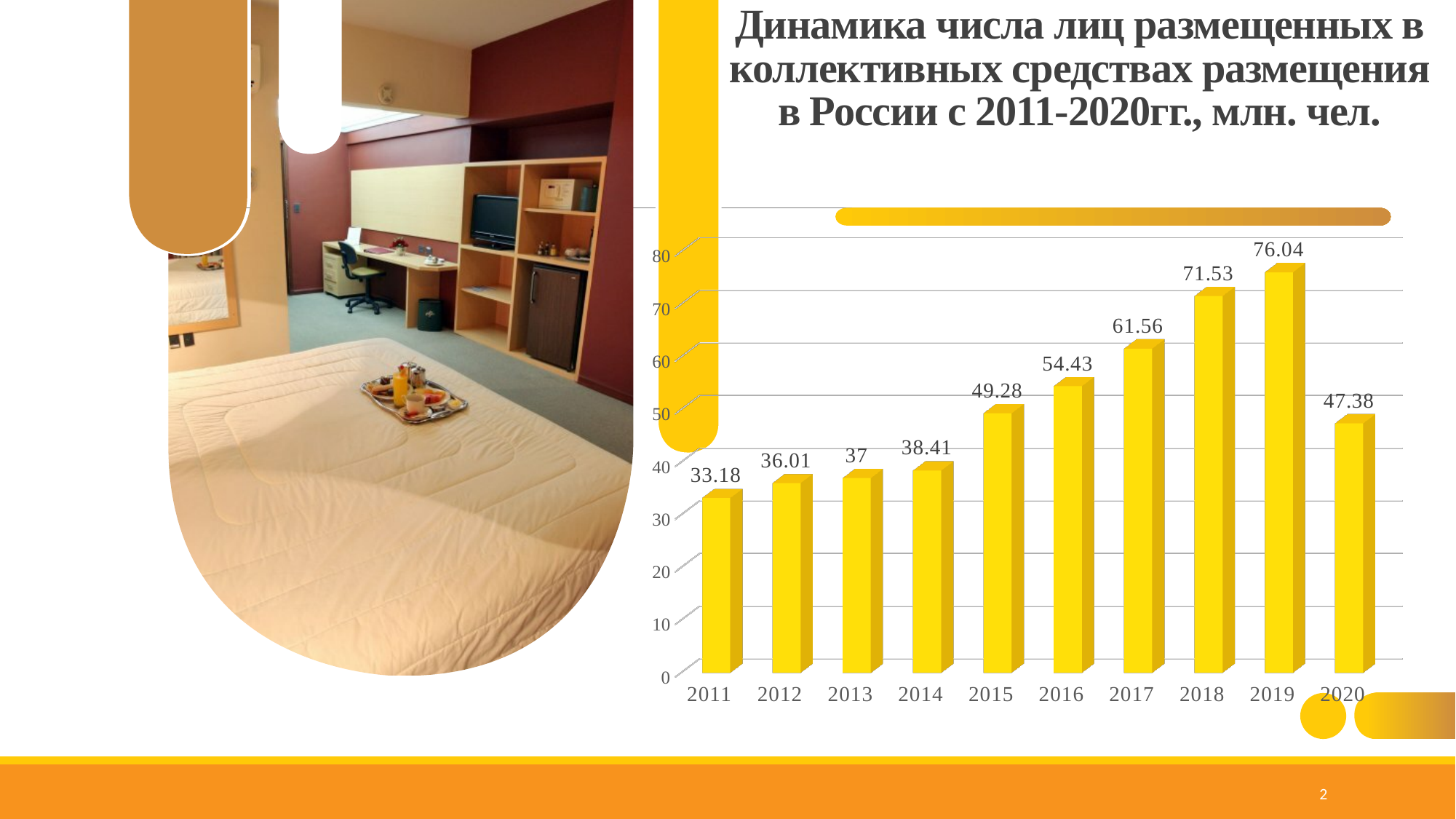
Which year has the lowest value? 2011 What is the difference between the values for 2019 and 2020? 28.66 What is the value for 2011? 33.18 How many years are shown on the x axis? 10 Is the value for 2015 greater or less than 40? greater Which is larger, the value for 2016 or the value for 2020? 2016 Do the values rise or fall from 2011 to 2019? rise What is the value for 2017? 61.56 What is the difference between the values for 2018 and 2017? 9.97 What kind of chart is shown on the slide? bar chart What is the value for 2020? 47.38 Which year has the highest value? 2019